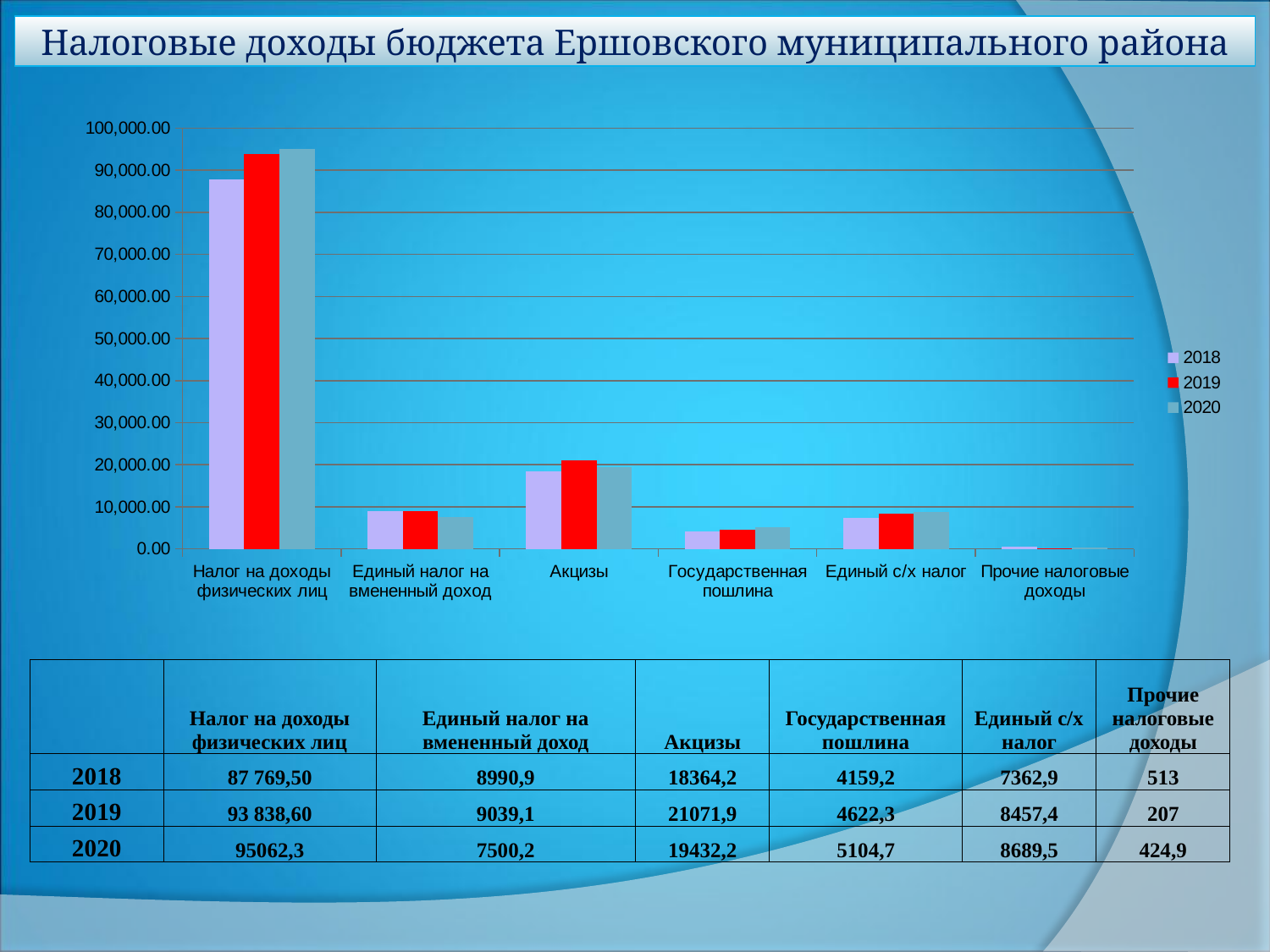
Is the 2019 value for Акцизы greater or less than 20,000.00? greater What is the value for Единый с/х налог in 2020? 8689,5 Which category has the lowest values in the chart? Прочие налоговые доходы Do the values for Государственная пошлина rise or fall from 2018 to 2020? rise How many categories are shown on the x axis of the chart? 6 What is the value for Акцизы in 2019? 21071,9 How many series does the legend list? 3 Which category has the highest values in the chart? Налог на доходы физических лиц What kind of chart is shown on the slide? bar chart What is the difference between the 2019 and 2018 values for Акцизы? 2707,7 Which is larger for Единый налог на вмененный доход: the 2019 value or the 2020 value? 2019 What is the value for Прочие налоговые доходы in 2018? 513